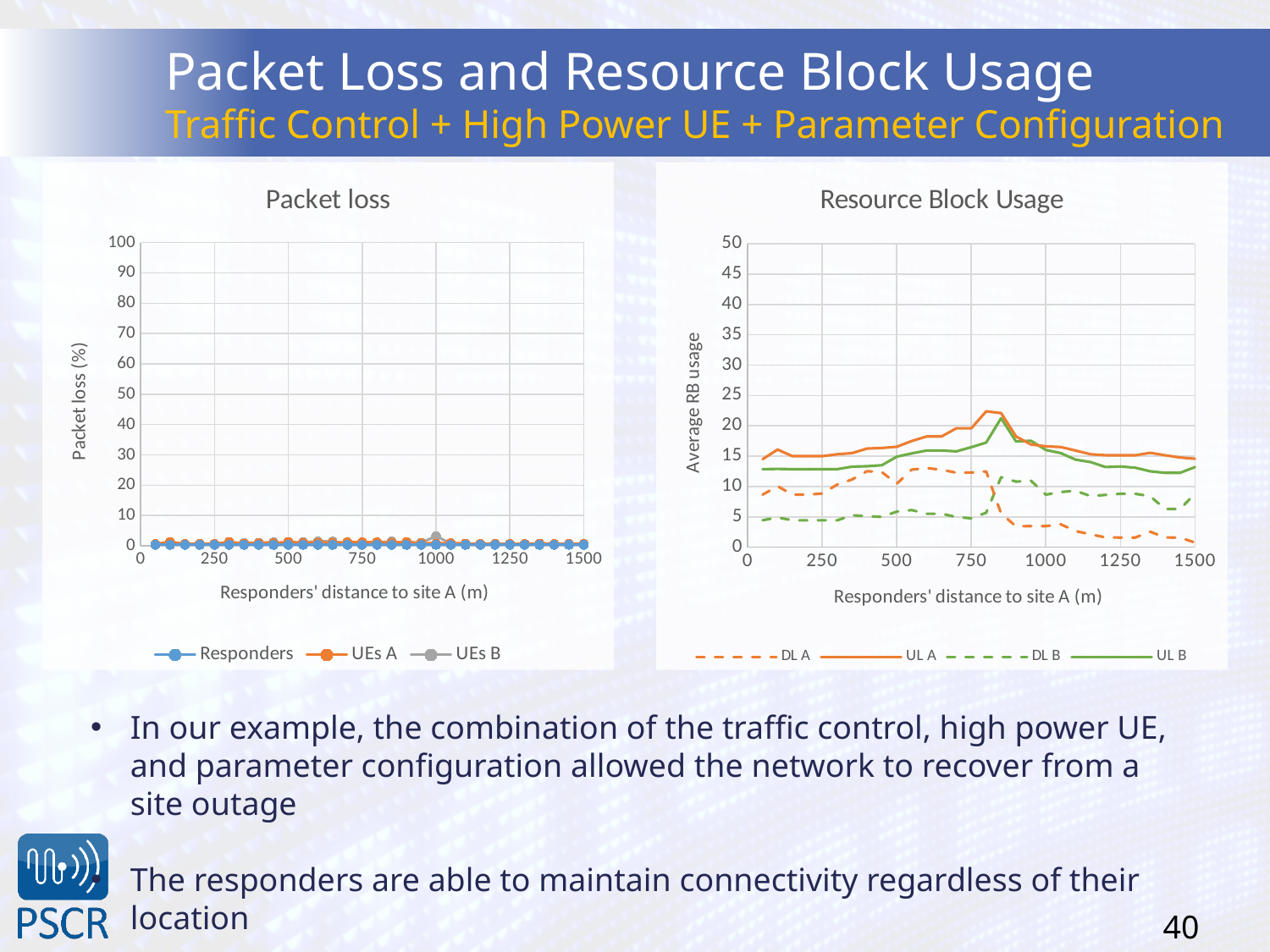
How many series does the legend of the Packet loss chart list? 3 In the Resource Block Usage chart, is the value for DL A at 1500 m greater or less than 5? less In the Packet loss chart, is the value for Responders at 500 m greater or less than 10? less In the Packet loss chart, is the value for UEs B at 1000 m greater or less than 10? less In the Resource Block Usage chart, which series has the highest value at 750 m? UL A In the Resource Block Usage chart, which series has the lowest value at 1500 m? DL A In the Resource Block Usage chart, does the DL A series rise or fall between 1000 m and 1500 m? fall How many series does the legend of the Resource Block Usage chart list? 4 What kind of chart is the Packet loss chart? line chart What is the y-axis label of the Resource Block Usage chart? Average RB usage